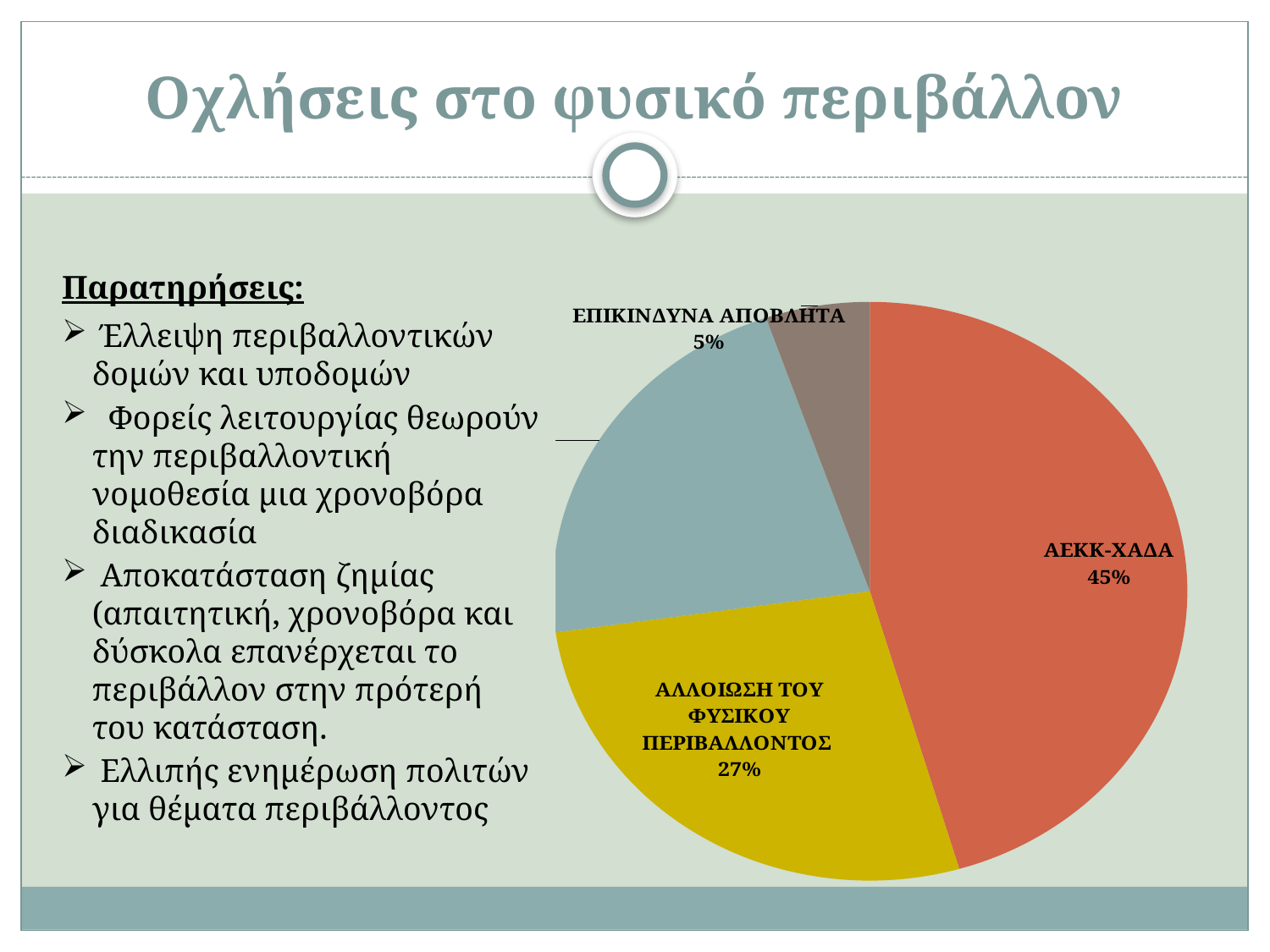
What colour is the ΑΕΚΚ-ΧΑΔΑ slice in the pie chart? Red Which category has the smallest slice in the pie chart? ΕΠΙΚΙΝΔΥΝΑ ΑΠΟΒΛΗΤΑ What percentage is shown for ΕΠΙΚΙΝΔΥΝΑ ΑΠΟΒΛΗΤΑ in the pie chart? 5% By how many percentage points does ΑΕΚΚ-ΧΑΔΑ exceed ΑΛΛΟΙΩΣΗ ΤΟΥ ΦΥΣΙΚΟΥ ΠΕΡΙΒΑΛΛΟΝΤΟΣ in the pie chart? 18 percentage points What percentage does the ΑΕΚΚ-ΧΑΔΑ slice represent in the pie chart? 45% How many slices does the pie chart have? 4 What percentage is shown for ΑΛΛΟΙΩΣΗ ΤΟΥ ΦΥΣΙΚΟΥ ΠΕΡΙΒΑΛΛΟΝΤΟΣ in the pie chart? 27% What is the difference in percentage points between ΑΛΛΟΙΩΣΗ ΤΟΥ ΦΥΣΙΚΟΥ ΠΕΡΙΒΑΛΛΟΝΤΟΣ and ΕΠΙΚΙΝΔΥΝΑ ΑΠΟΒΛΗΤΑ? 22 percentage points What share of the pie does the ΑΕΚΚ-ΧΑΔΑ slice take up? 45% What type of chart is shown on the slide? Pie chart Which category has the largest slice in the pie chart? ΑΕΚΚ-ΧΑΔΑ Which is larger in the pie chart: ΑΛΛΟΙΩΣΗ ΤΟΥ ΦΥΣΙΚΟΥ ΠΕΡΙΒΑΛΛΟΝΤΟΣ or ΕΠΙΚΙΝΔΥΝΑ ΑΠΟΒΛΗΤΑ? ΑΛΛΟΙΩΣΗ ΤΟΥ ΦΥΣΙΚΟΥ ΠΕΡΙΒΑΛΛΟΝΤΟΣ